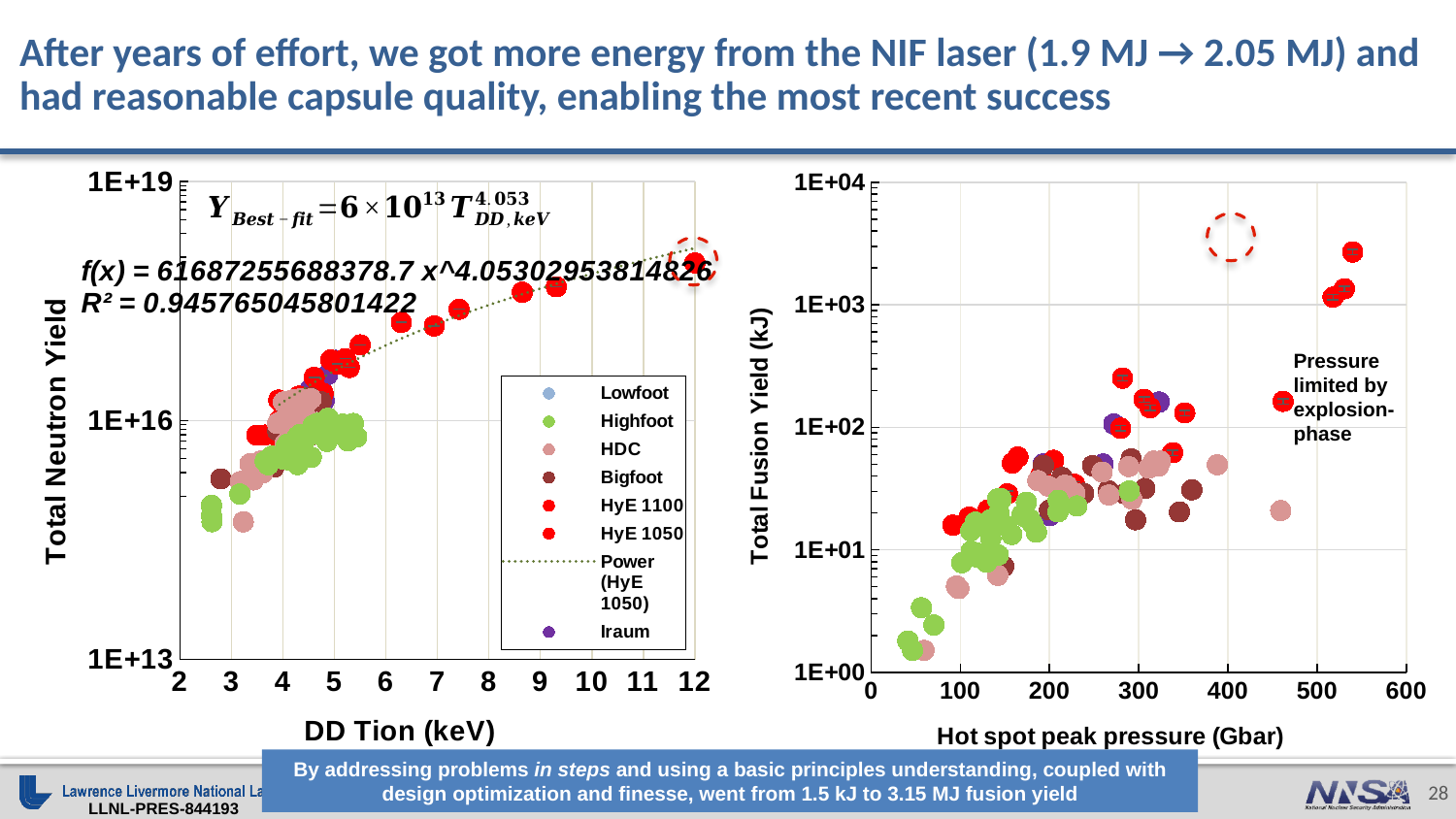
What is the y-axis label of the right chart? Total Fusion Yield (kJ) How many entries does the legend of the left chart list? 8 What kind of chart is the left chart (Total Neutron Yield vs DD Tion)? scatter chart In the left chart, does Total Neutron Yield generally rise or fall as DD Tion increases? rise What is the x-axis label of the left chart? DD Tion (keV) In the left chart, is the Total Neutron Yield of the point at the highest DD Tion greater or less than 1E+16? greater In the right chart, is the Hot spot peak pressure of the rightmost point greater or less than 600 Gbar? less In the right chart, does Total Fusion Yield generally rise or fall as Hot spot peak pressure increases? rise In the left chart, is the Total Neutron Yield of the lowest points near 2.5 keV greater or less than 1E+16? less What kind of chart is the right chart (Total Fusion Yield vs Hot spot peak pressure)? scatter chart